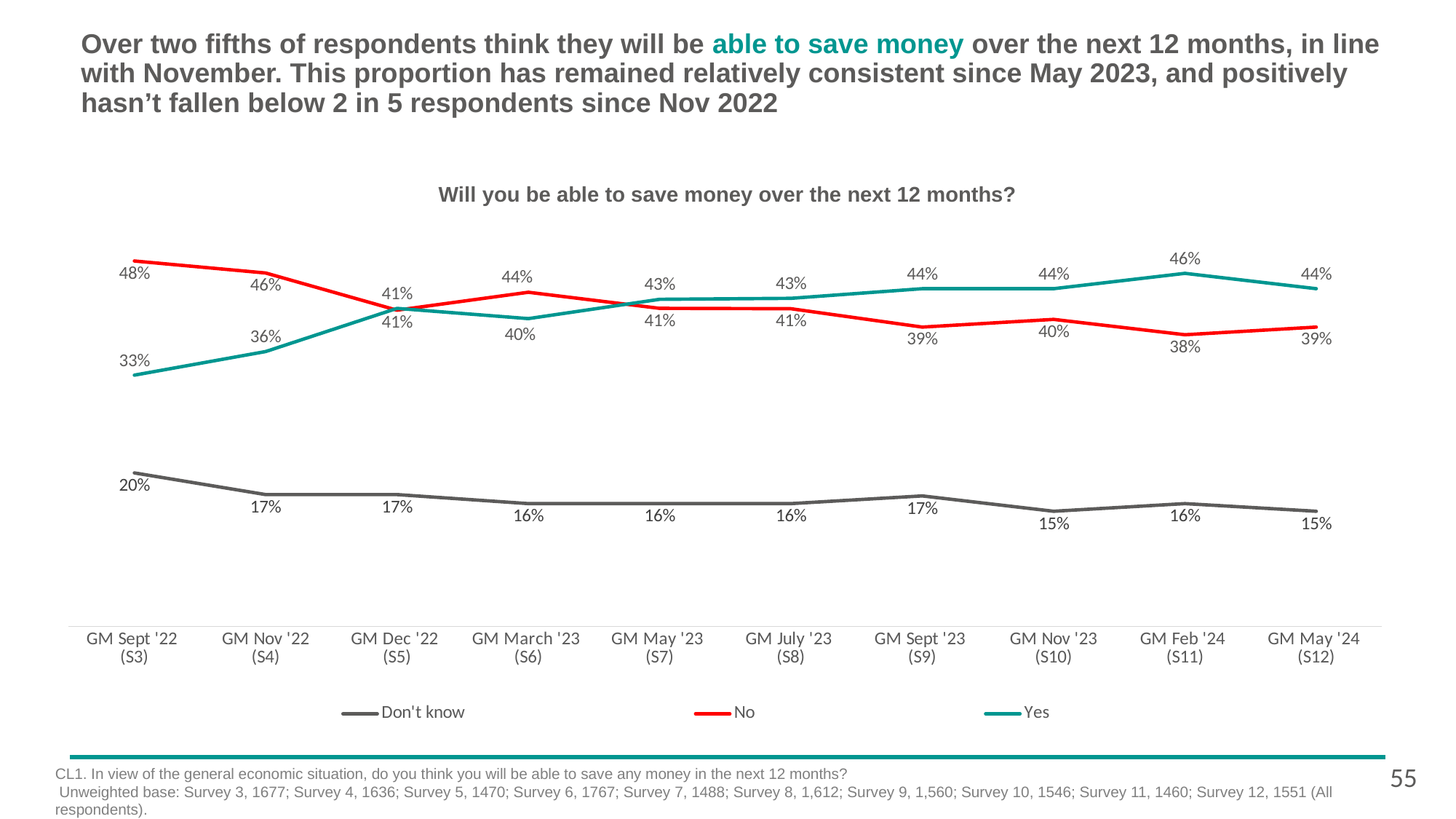
What is the value for 'Yes' at GM Feb '24 (S11)? 46% At which survey wave is the 'Yes' series at its highest? GM Feb '24 (S11) What is the value for 'Don't know' at GM May '24 (S12)? 15% How many survey waves (points) are plotted along the x axis? 10 Which colour is used for the 'Yes' line? Teal At GM May '24 (S12), which is larger, 'Yes' or 'No'? Yes Does the 'No' series generally rise or fall from GM Sept '22 to GM May '24? Fall How many series does the legend list? 3 At which survey wave is the 'Yes' series at its lowest? GM Sept '22 (S3) What is the value for 'No' at GM Sept '22 (S3)? 48% What is the difference between 'No' and 'Yes' at GM Sept '22 (S3)? 15 percentage points What type of chart is shown on the slide? Line chart